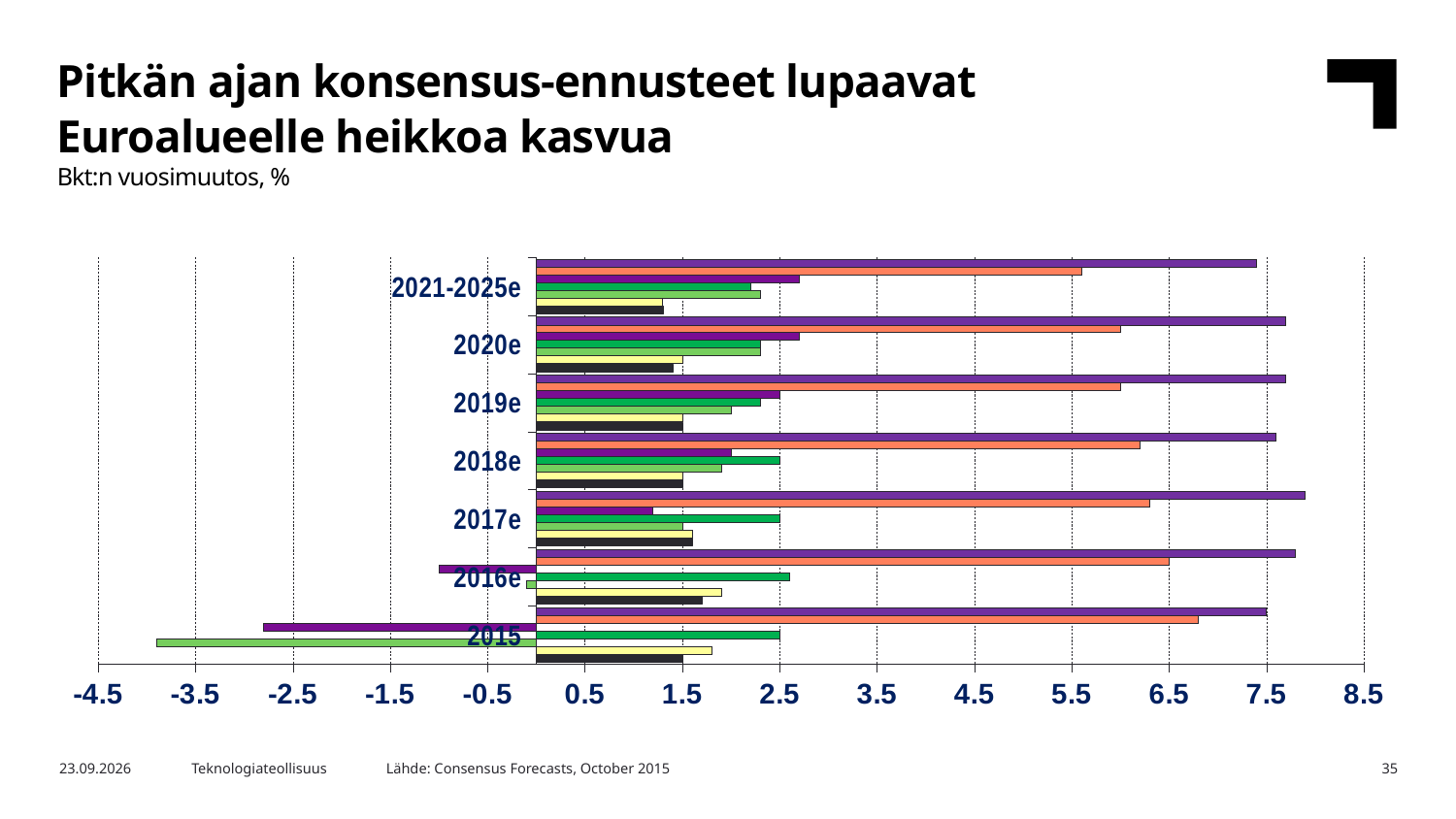
How many categories (years or periods) are shown on the chart? 7 How many bars are plotted for each category on the chart? 7 Is the value of the black bar for 2021-2025e greater or less than 2.5? less What kind of chart is shown on the slide? bar chart What does the subtitle say the chart measures? Bkt:n vuosimuutos, % What is the title of the slide? Pitkän ajan konsensus-ennusteet lupaavat Euroalueelle heikkoa kasvua Is the value of the purple bar for 2015 greater or less than 6.5? greater Is the value of the magenta bar for 2015 greater or less than -1.5? less For 2017e, which is longer: the purple bar or the orange bar? the purple bar